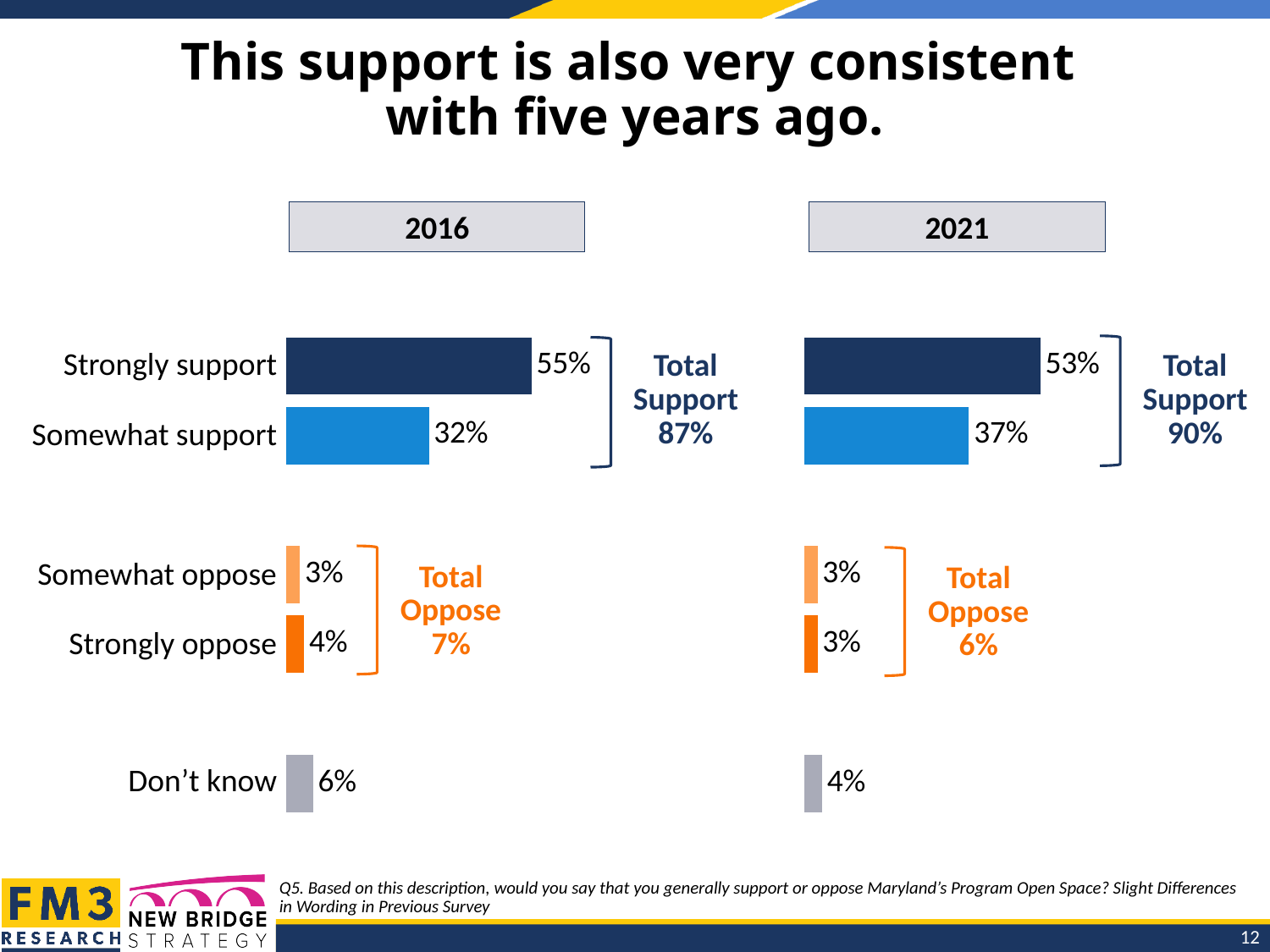
In the 2016 chart, what is the Total Support percentage? 87% In the 2016 chart, what is the difference between Strongly support and Somewhat support? 23% In the 2016 chart, what percentage strongly support? 55% How many response categories are shown in the 2016 chart? 5 What is the difference between the Strongly support values in the 2016 and 2021 charts? 2% In the 2016 chart, which category has the highest value? Strongly support What type of chart is used on this slide? Bar chart In the 2021 chart, what is the Total Oppose percentage? 6% Is the Somewhat support value larger in the 2016 chart or the 2021 chart? 2021 In the 2021 chart, what percentage somewhat support? 37% In the 2021 chart, which category has the lowest value? Somewhat oppose and Strongly oppose (both 3%) In the 2021 chart, what percentage answered Don't know? 4%